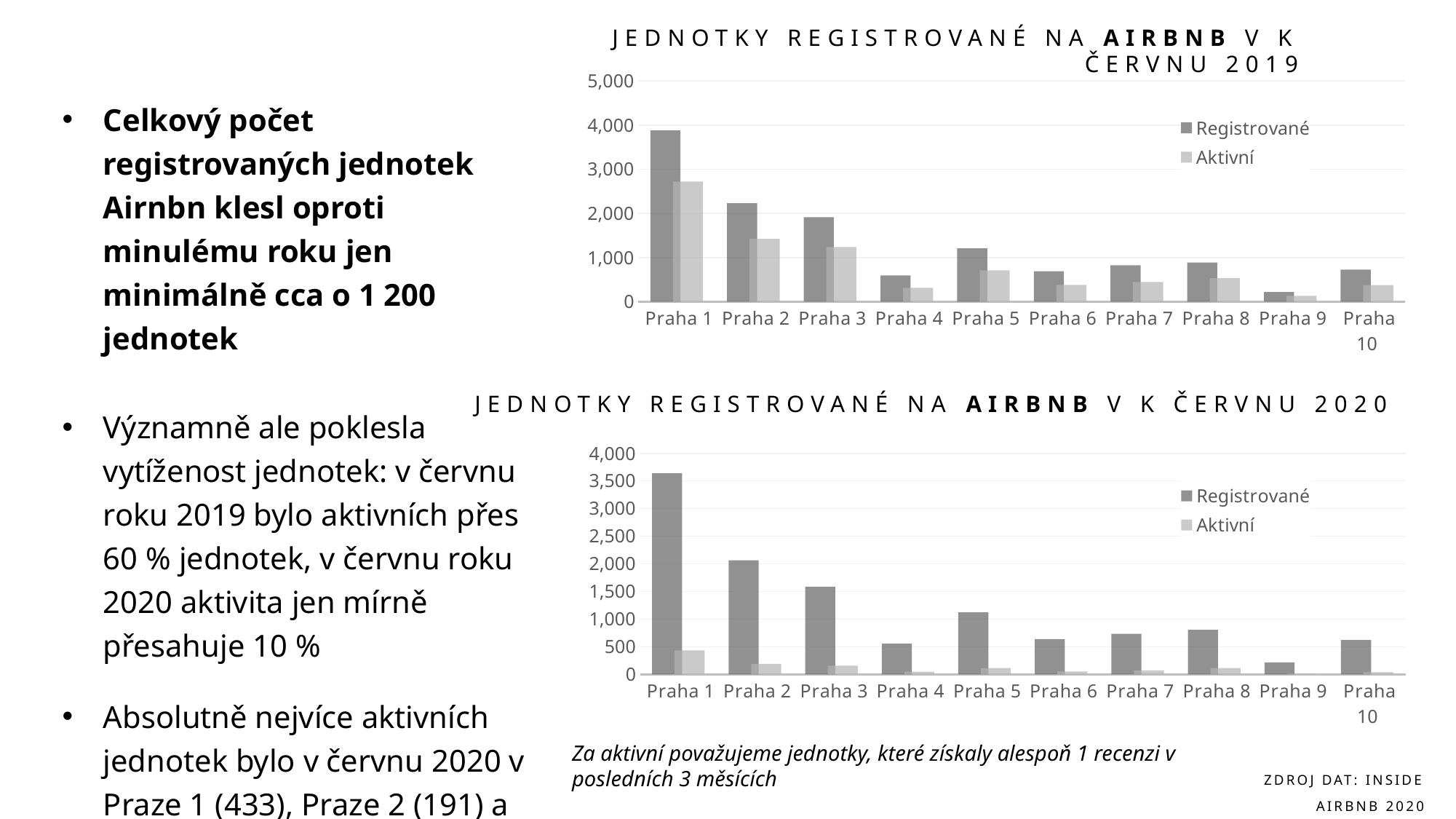
In the top chart (červnu 2019), which is larger: the Registrované value for Praha 2 or for Praha 3? Praha 2 In the bottom chart (červnu 2020), which category has the lowest Registrované value? Praha 9 In the bottom chart (červnu 2020), is the Registrované value for Praha 1 greater or less than 3,000? greater What are the two legend entries in the top chart (červnu 2019)? Registrované and Aktivní How many categories are shown on the x axis of the top chart (červnu 2019)? 10 In the top chart (červnu 2019), is the Registrované value for Praha 1 greater or less than 3,000? greater In the bottom chart (červnu 2020), is the Aktivní value for Praha 1 greater or less than 500? less How many series does the legend of the bottom chart (červnu 2020) list? 2 In the top chart (červnu 2019), which category has the lowest Registrované value? Praha 9 In the top chart (červnu 2019), which category has the highest Registrované value? Praha 1 What kind of chart is the top chart, 'Jednotky registrované na Airbnb v k červnu 2019'? bar chart